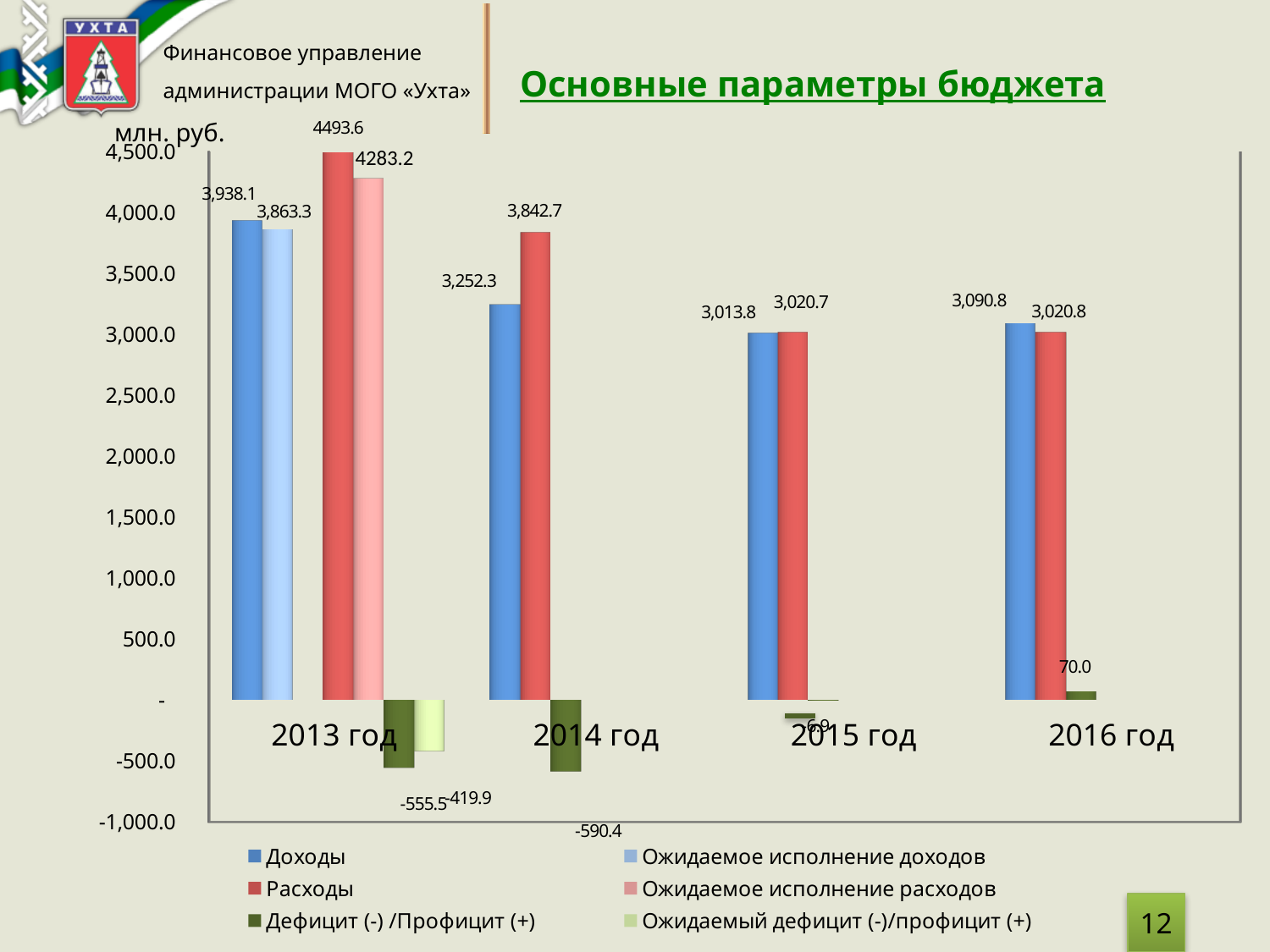
In 2016 год, which is larger: Доходы or Расходы? Доходы Is the value of Доходы for 2013 год greater or less than 3,500.0? greater What is the value of Доходы for 2014 год? 3,252.3 Do the Расходы values rise or fall from 2013 год to 2015 год? fall In which year is Расходы the highest? 2013 год What is the value of Ожидаемое исполнение расходов for 2013 год? 4283.2 In which year is Доходы the lowest? 2015 год How many series does the legend list? 6 By how much do Расходы exceed Доходы in 2014 год? 590.4 What is the value of Расходы for 2013 год? 4493.6 How many years are shown on the x axis? 4 What is the value of Дефицит (-) /Профицит (+) for 2016 год? 70.0